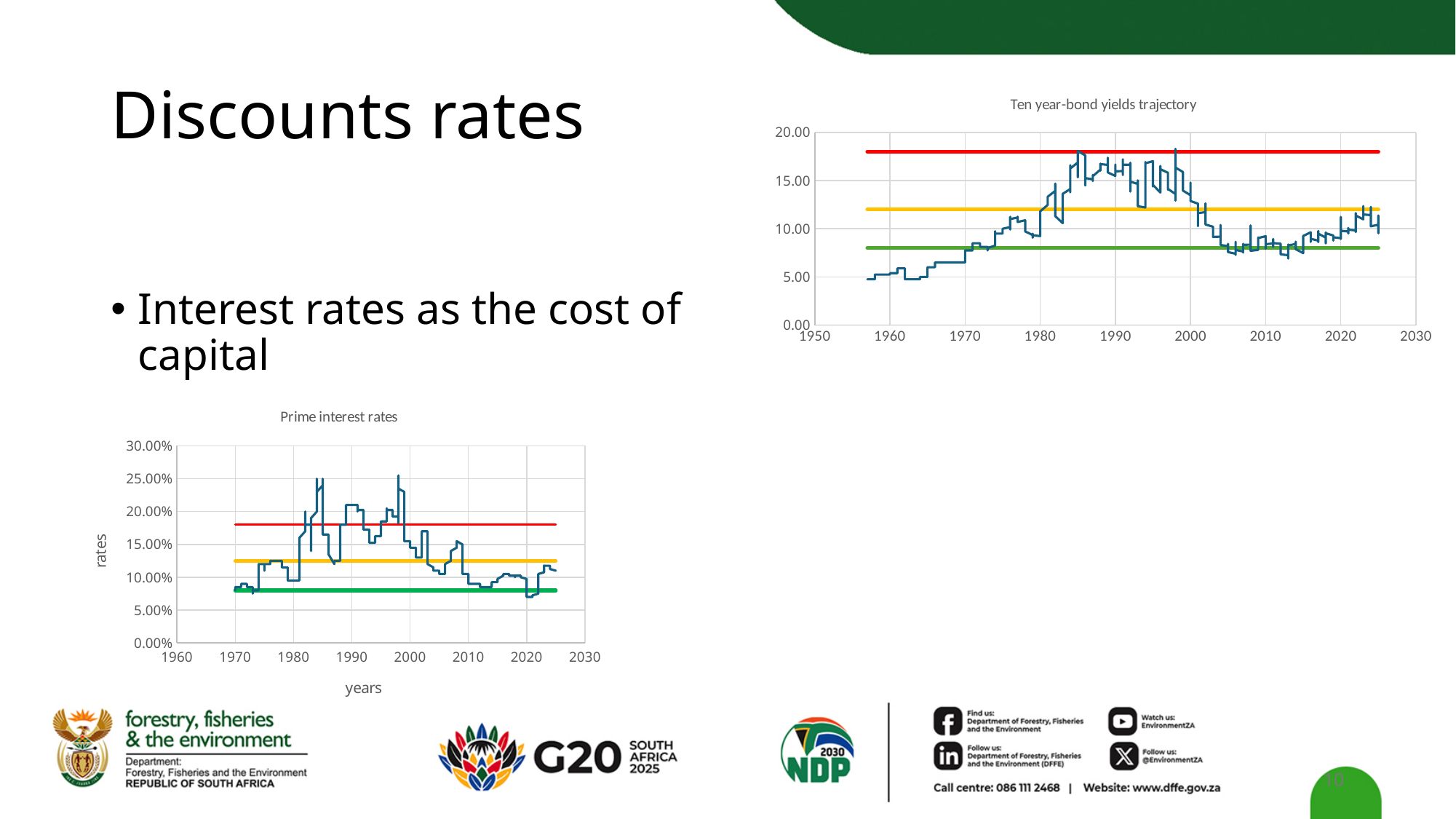
In the 'Ten year-bond yields trajectory' chart, do the values generally rise or fall between 1960 and 1985? rise What kind of chart is the 'Ten year-bond yields trajectory' chart? Line chart In the 'Ten year-bond yields trajectory' chart, is the value around 1960 greater or less than 10.00? less What is the x-axis label of the 'Prime interest rates' chart? years In the 'Prime interest rates' chart, is the value around 1970 greater or less than 10.00%? less In the 'Ten year-bond yields trajectory' chart, is the value around 1985 greater or less than 15.00? greater What kind of chart is the 'Prime interest rates' chart? Line chart What is the y-axis label of the 'Prime interest rates' chart? rates In the 'Prime interest rates' chart, do the values generally rise or fall between 2000 and 2010? fall How many charts are shown on the slide? 2